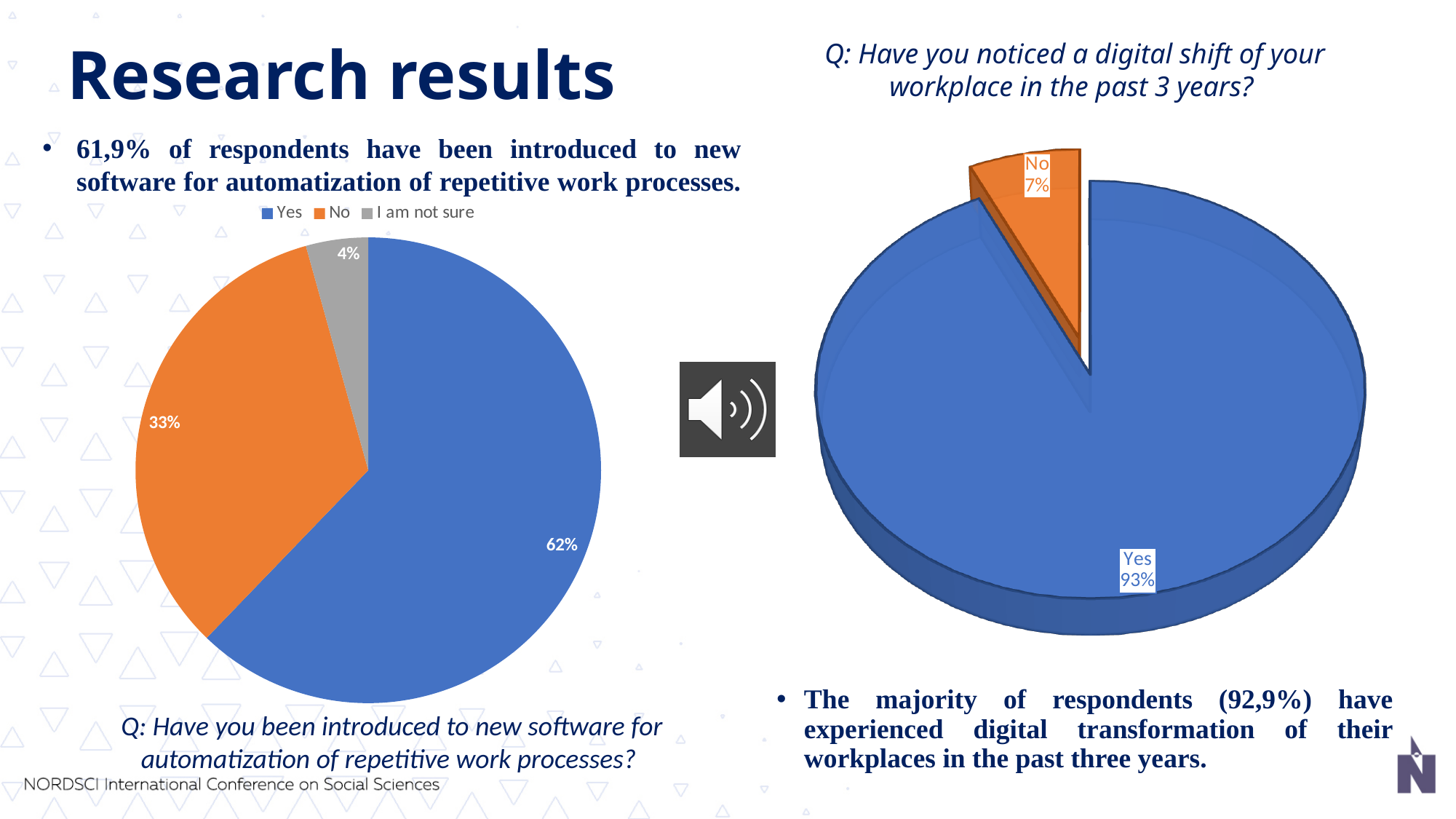
In the left pie chart about new software for automatization of repetitive work processes, which answer has the smallest slice? I am not sure In the right pie chart about a digital shift of the workplace in the past 3 years, what colour is the No slice? Orange In the left pie chart about new software for automatization of repetitive work processes, what share of respondents answered No? 33% In the left pie chart about new software for automatization of repetitive work processes, which answer has the largest slice? Yes In the left pie chart about new software for automatization of repetitive work processes, what share of respondents answered 'I am not sure'? 4% In the right pie chart about a digital shift of the workplace in the past 3 years, what share of respondents answered No? 7% In the left pie chart about new software for automatization of repetitive work processes, what share of respondents answered Yes? 62% What type of chart is the chart on the left of the slide? Pie chart In the right pie chart about a digital shift of the workplace in the past 3 years, what share of respondents answered Yes? 93% In the left pie chart about new software for automatization of repetitive work processes, how many percentage points larger is the Yes slice than the No slice? 29 In the left pie chart about new software for automatization of repetitive work processes, how many categories does the legend list? 3 In the right pie chart about a digital shift of the workplace in the past 3 years, which answer is larger, Yes or No? Yes